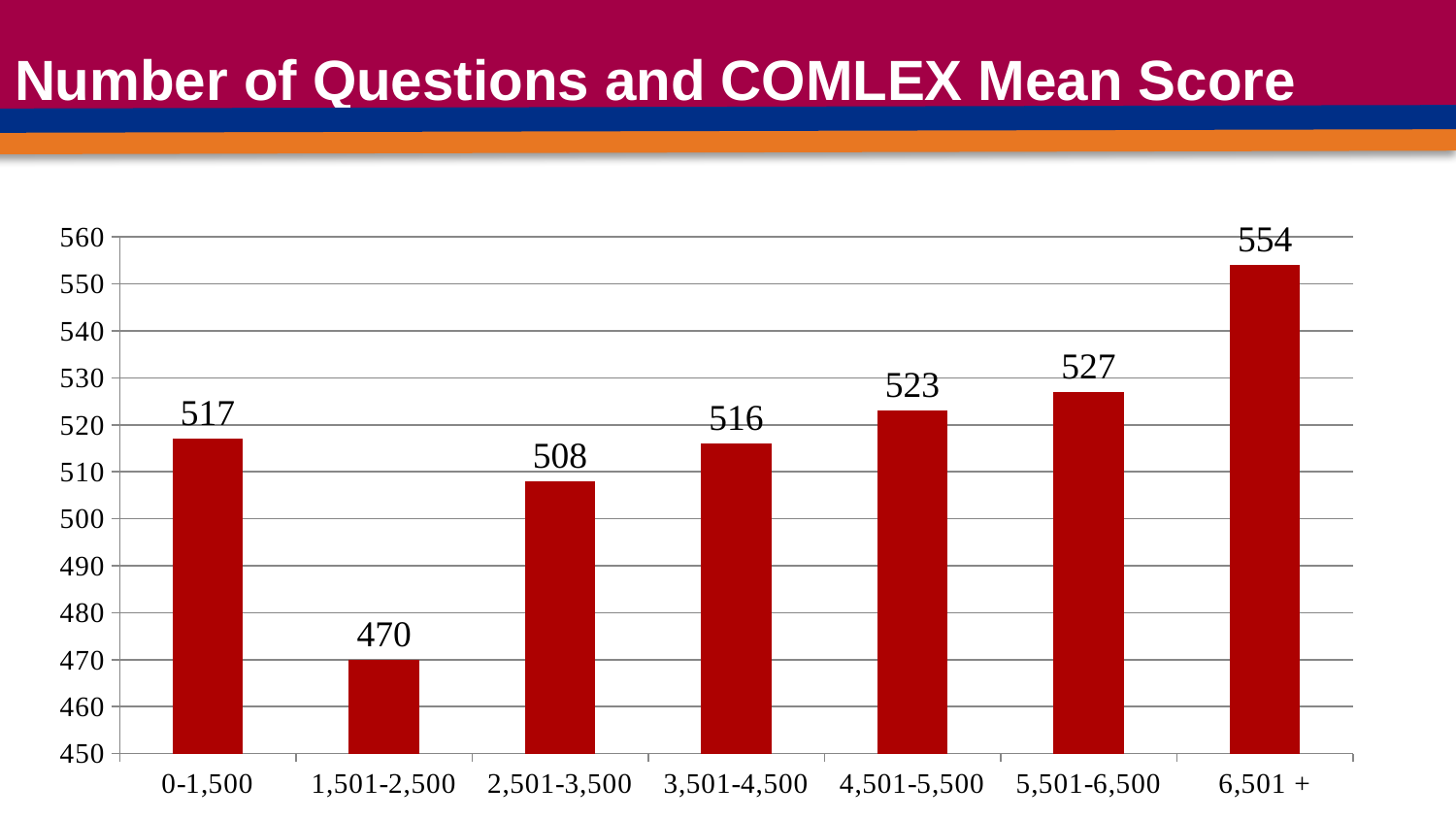
How many question-count categories are shown on the chart? 7 What is the difference between the mean scores for 6,501 + and 1,501-2,500? 84 Which category has the lowest COMLEX mean score? 1,501-2,500 What is the COMLEX mean score for the 0-1,500 questions category? 517 What is the difference between the mean scores for 5,501-6,500 and 4,501-5,500? 4 What is the COMLEX mean score for the 6,501 + questions category? 554 Which category has the highest COMLEX mean score? 6,501 + What is the COMLEX mean score for the 1,501-2,500 questions category? 470 Is the value for 2,501-3,500 greater or less than 500? greater What kind of chart is shown on the slide? Bar chart What is the title of the chart? Number of Questions and COMLEX Mean Score Which has a higher mean score, 0-1,500 or 3,501-4,500? 0-1,500